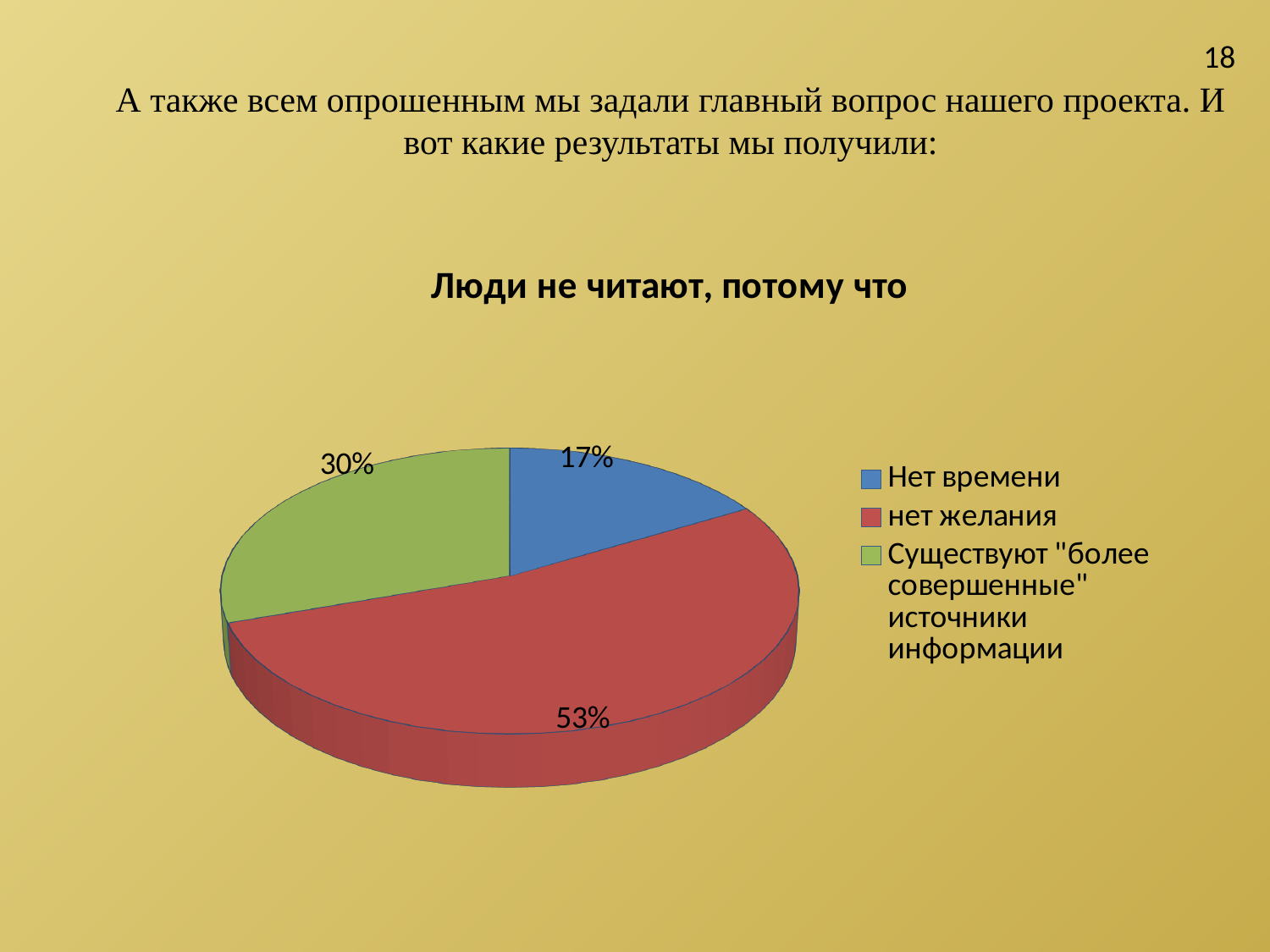
What is the difference in percentage points between "Существуют "более совершенные" источники информации" and "Нет времени"? 13 What type of chart is shown on the slide? Pie chart What is the difference in percentage points between "нет желания" and "Нет времени"? 36 Which category has the smallest share of the pie? Нет времени Which category has the largest share of the pie? нет желания How many categories does the legend list? 3 What share of the pie is labelled "Нет времени"? 17% What colour is the slice for "нет желания"? Red What is the title of the chart? Люди не читают, потому что Which is larger: the share for "Нет времени" or the share for "Существуют "более совершенные" источники информации"? Существуют "более совершенные" источники информации What share of the pie is labelled "Существуют "более совершенные" источники информации"? 30% What share of the pie is labelled "нет желания"? 53%